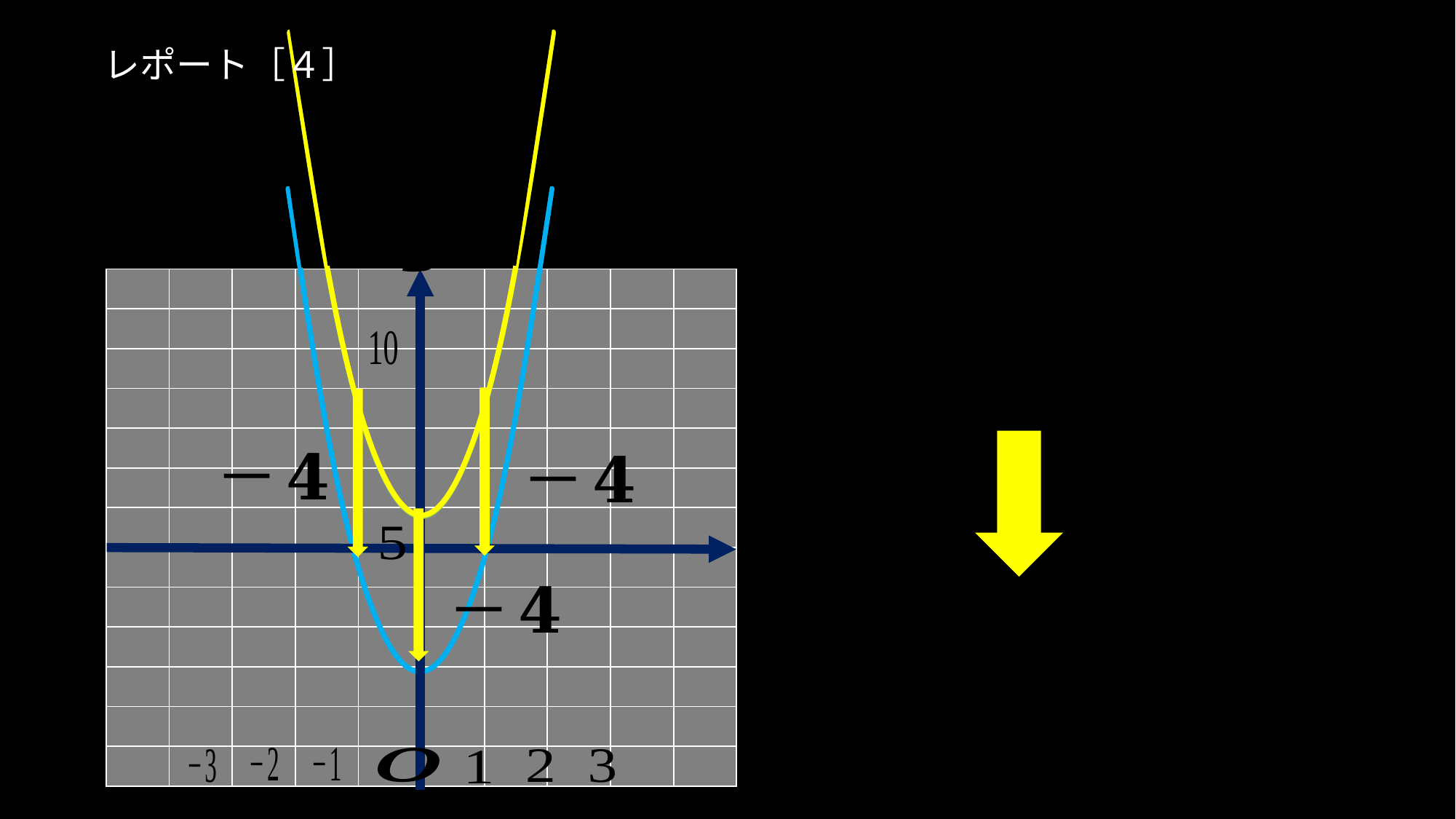
What colours are the two curves plotted on the grid? Yellow and light blue How many vertical arrows labelled −4 are drawn between the two curves? 3 Do the curves open upward or downward? Upward Which tick labels are printed on the vertical axis? 5 and 10 What is the largest tick label printed on the horizontal axis? 3 What number is written next to each of the three vertical arrows between the curves? −4 Which curve has its lowest point (vertex) higher up, the yellow one or the blue one? The yellow one Is the vertex of the blue curve above or below the horizontal axis arrow? Below What is the title text at the top left of the slide? レポート［4］ How many curves are plotted on the grid? 2 What is the smallest tick label printed on the horizontal axis? -3